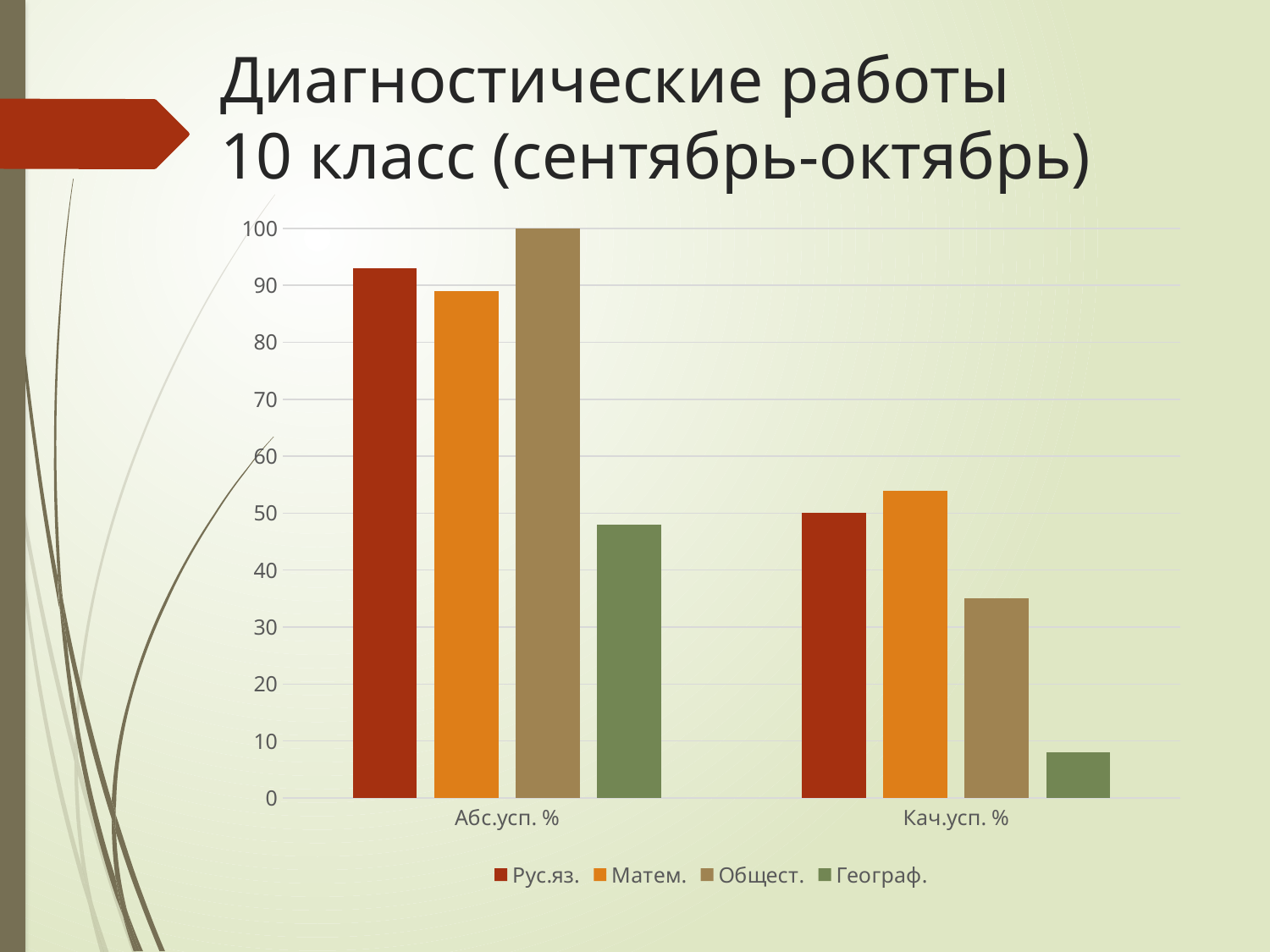
Which series has the lowest value in the Кач.усп. % category? Географ. How many categories are shown on the x axis? 2 Which is larger in the Кач.усп. % category: Общест. or Географ.? Общест. Is the value for Географ. in the Абс.усп. % category greater or less than 40? greater Which series has the highest value in the Абс.усп. % category? Общест. Which series has the lowest value in the Абс.усп. % category? Географ. How many series does the legend list? 4 What type of chart is shown on the slide? bar chart Which series has the highest value in the Кач.усп. % category? Матем. Is the value for Общест. in the Кач.усп. % category greater or less than 40? less What is the value for Общест. in the Абс.усп. % category? 100 What is the value for Рус.яз. in the Кач.усп. % category? 50